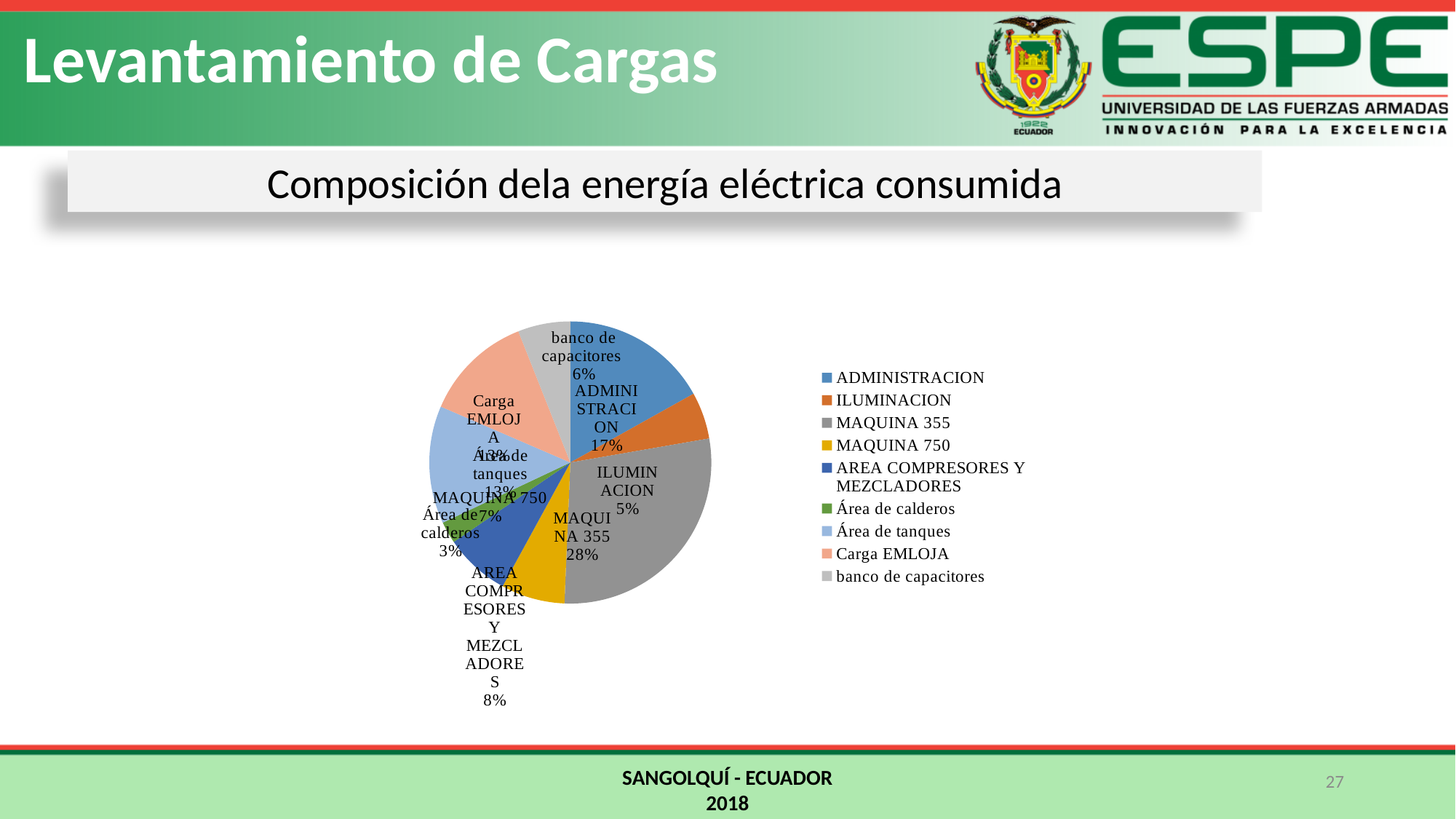
What share of the consumed electrical energy corresponds to MAQUINA 355? 28% What percentage does ADMINISTRACION represent in the pie chart? 17% What percentage is shown for Área de tanques? 13% By how many percentage points does MAQUINA 355 exceed ADMINISTRACION? 11 percentage points How many categories are listed in the legend of the pie chart? 9 Which category has the largest slice of the pie chart? MAQUINA 355 What share does AREA COMPRESORES Y MEZCLADORES have in the pie chart? 8% What type of chart is used to show the composition of consumed electrical energy? Pie chart What percentage is labelled for banco de capacitores? 6% Which is larger, the share for ADMINISTRACION or the share for MAQUINA 750? ADMINISTRACION Which category has the smallest slice of the pie chart? Área de calderos What is the share shown for ILUMINACION? 5%